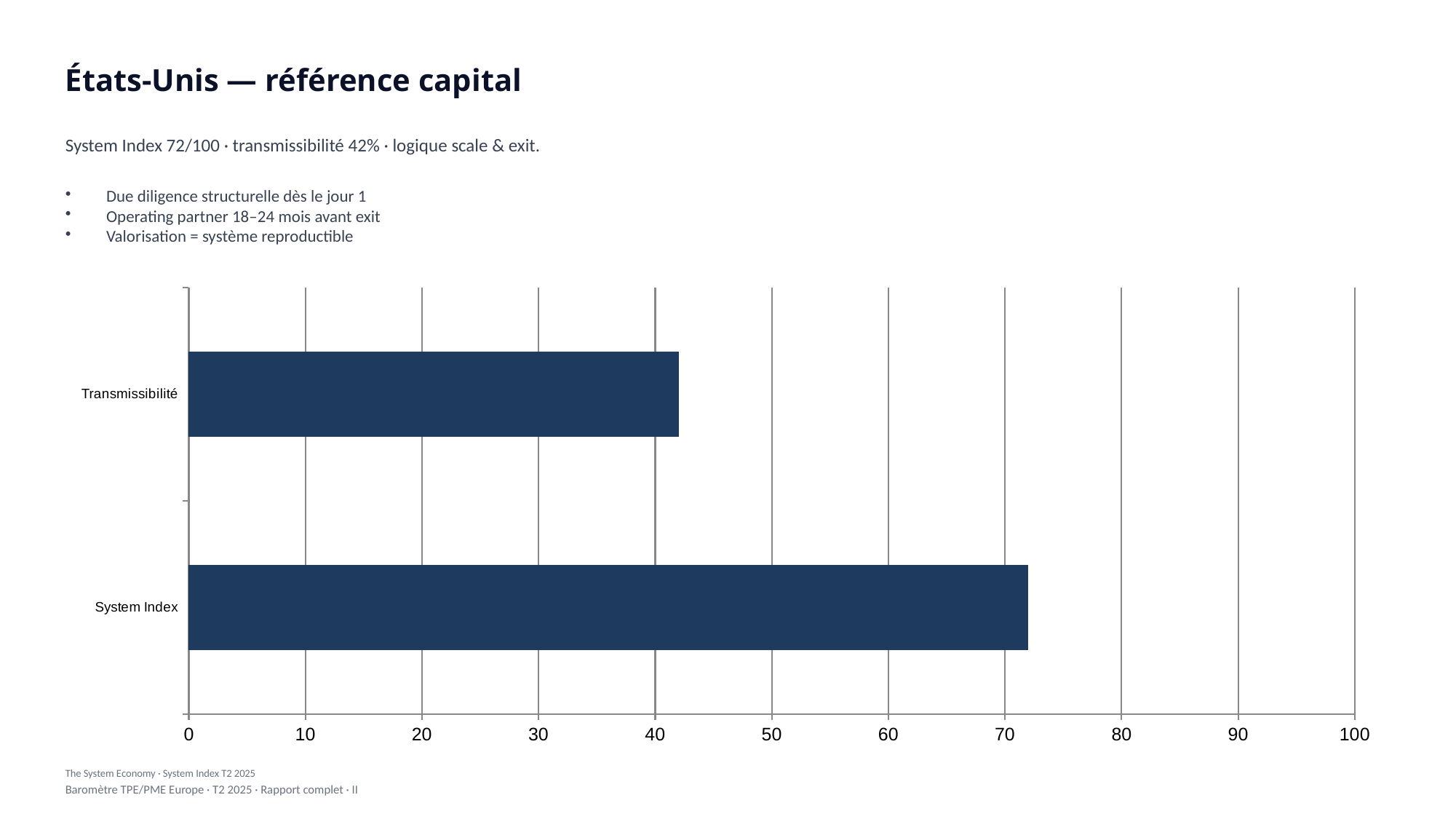
Is the value for System Index greater or less than 80? less What is the maximum value shown on the horizontal axis of the chart? 100 Is the value for System Index greater or less than 70? greater Which category has the lowest value in the chart? Transmissibilité Is the value for Transmissibilité greater or less than 40? greater Which category has the highest value in the chart? System Index What is the title of the slide containing the chart? États-Unis — référence capital How many categories does the chart show? 2 What kind of chart is shown on the slide? bar chart Which is larger, the value for System Index or the value for Transmissibilité? System Index